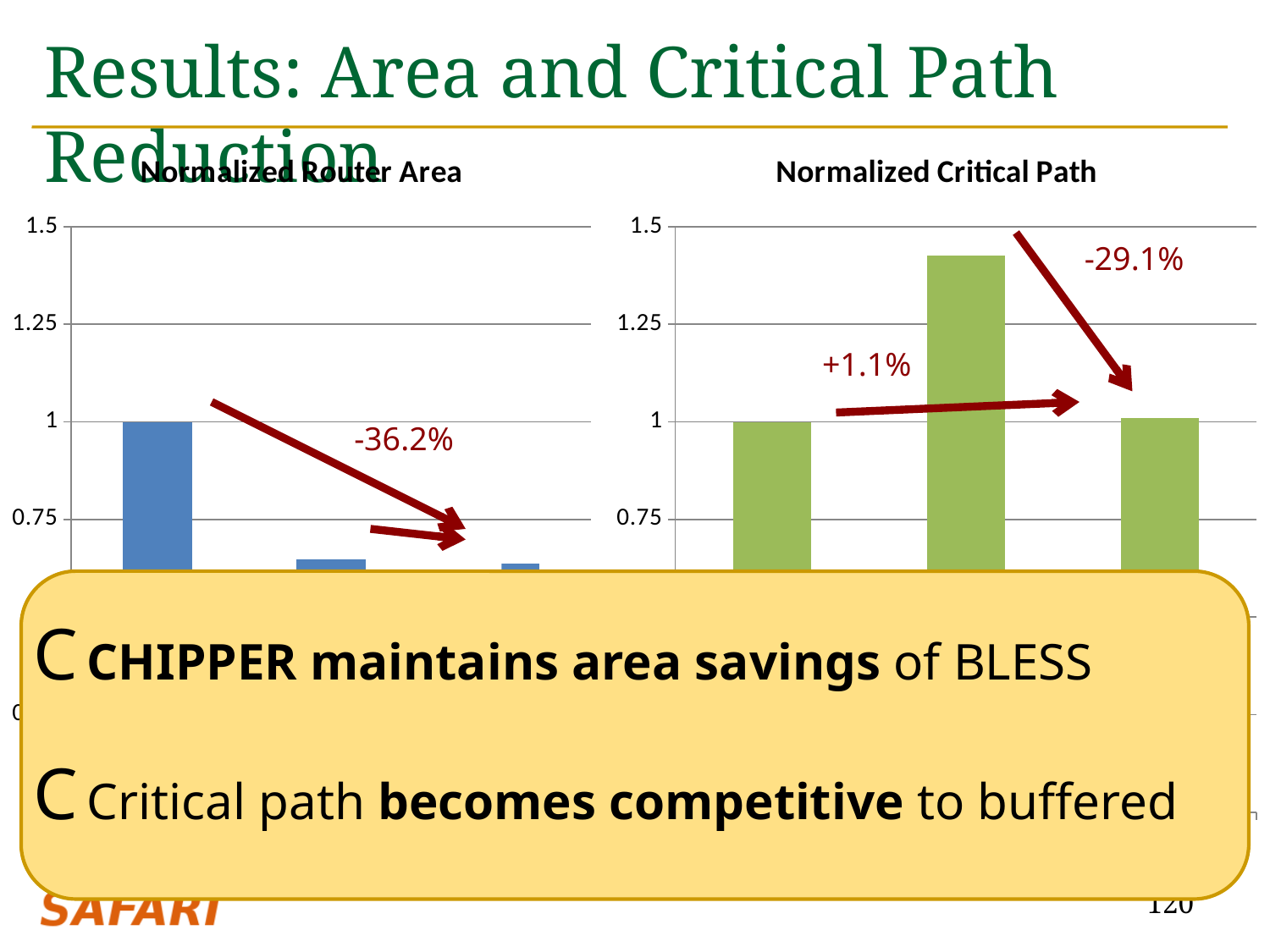
In the Normalized Router Area chart, which is larger, the first bar or the second bar? the first bar In the Normalized Critical Path chart, which is larger, the second bar or the third bar? the second bar In the Normalized Critical Path chart, what is the value of the first (leftmost) bar? 1 In the Normalized Router Area chart, which bar is the highest? the first (leftmost) bar What percentage change is annotated on the Normalized Router Area chart? -36.2% In the Normalized Critical Path chart, is the value of the second (middle) bar greater or less than 1.25? greater In the Normalized Router Area chart, do the bar values rise or fall from left to right? fall What kind of chart is the Normalized Router Area chart? bar chart How many bars are plotted in the Normalized Critical Path chart? 3 In the Normalized Router Area chart, is the value of the third (rightmost) bar greater or less than 0.75? less In the Normalized Router Area chart, what is the value of the first (leftmost) bar? 1 In the Normalized Critical Path chart, which bar is the highest? the second (middle) bar